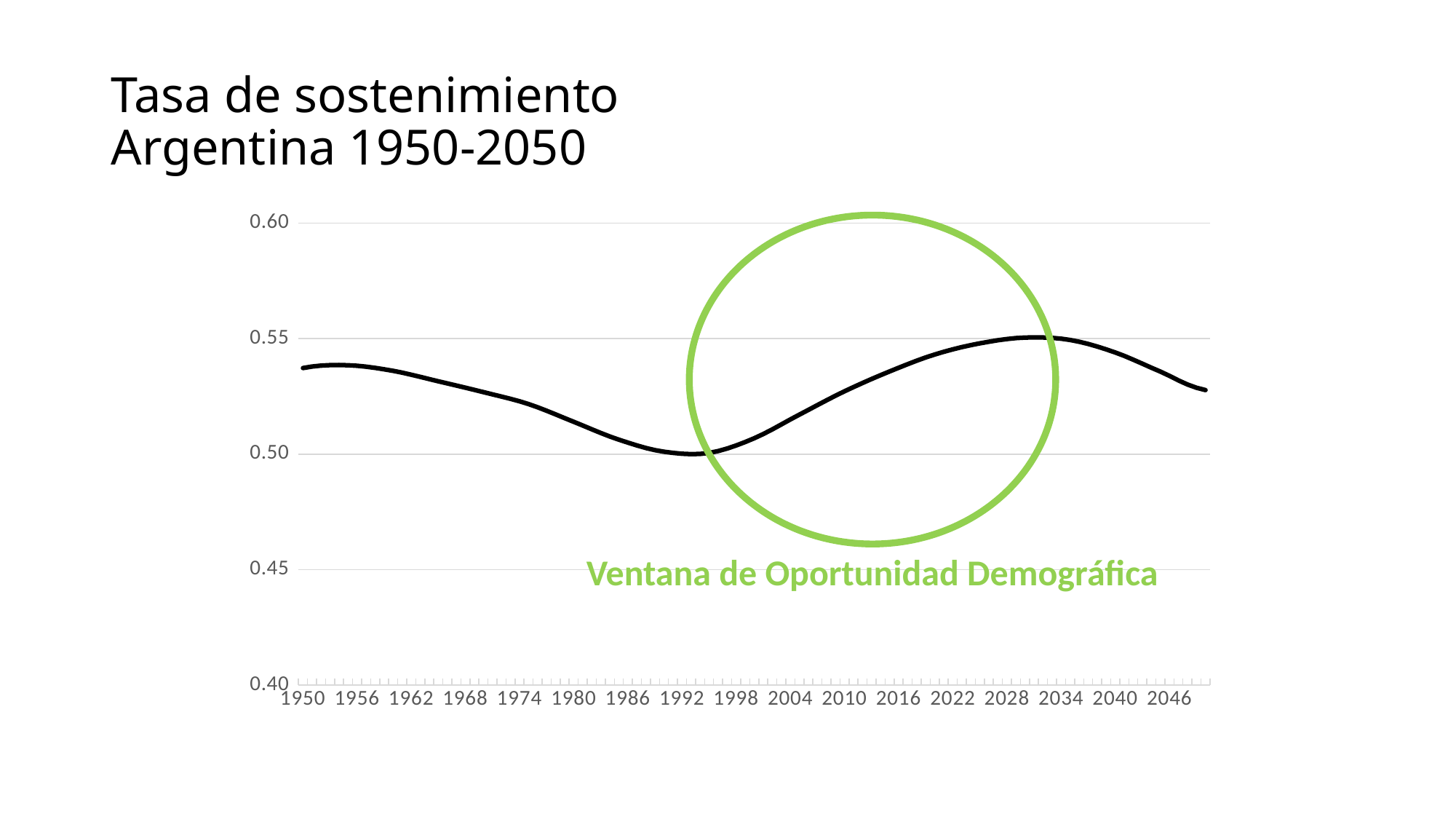
Is the value for 1980 greater or less than 0.55? less What text is written in green below the circle on the chart? Ventana de Oportunidad Demográfica Is the value for 2010 greater or less than 0.50? greater Does the line rise or fall between 1998 and 2028? rise Is the value for 1992 greater or less than 0.55? less What is the title of the chart on the slide? Tasa de sostenimiento Argentina 1950-2050 Which year has the higher value, 1992 or 2030? 2030 What kind of chart is shown on the slide? line chart Does the line rise or fall between 1950 and 1992? fall